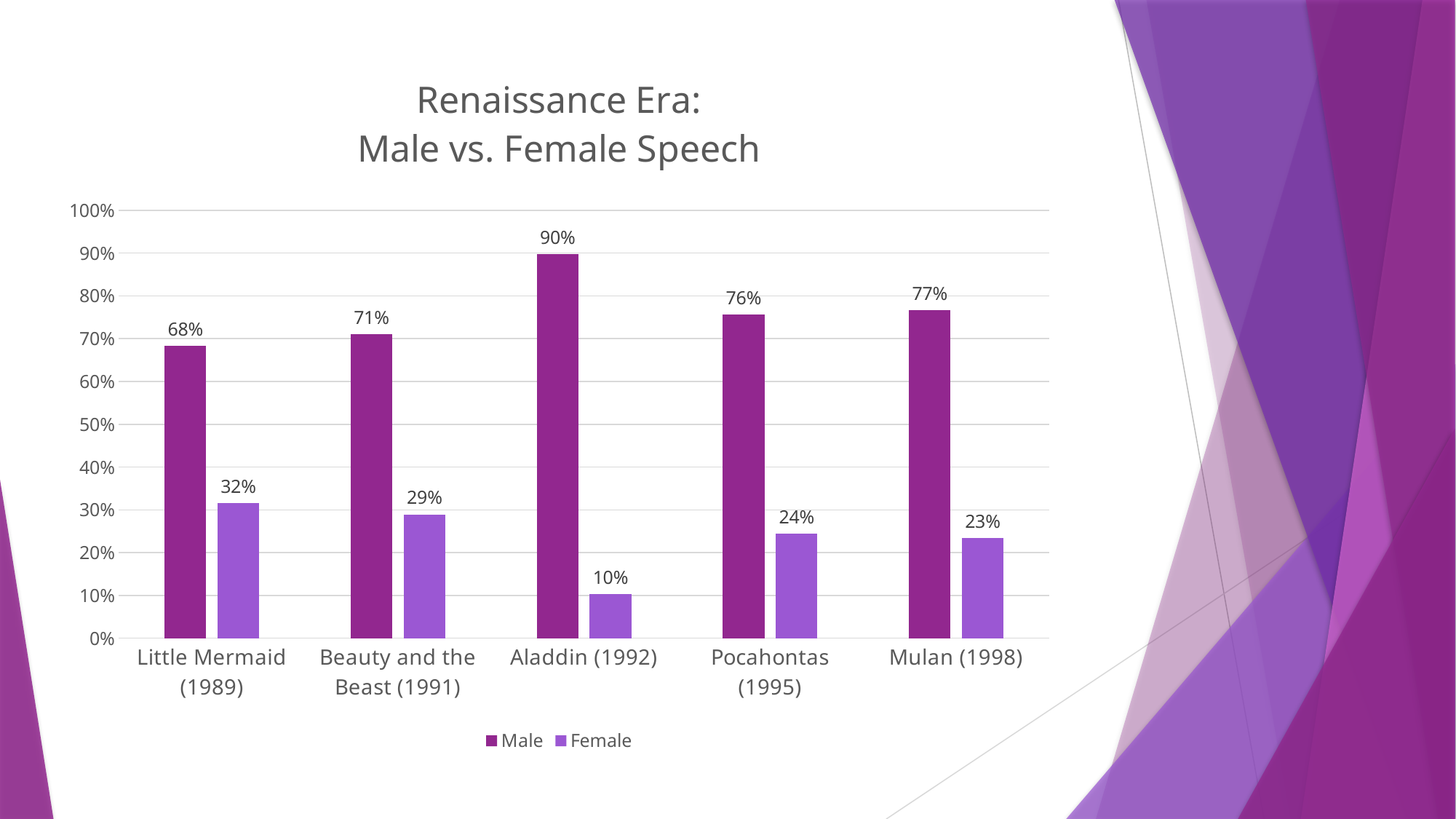
Which film has the highest Male speech percentage? Aladdin (1992) How many films are shown on the x axis? 5 Which film has the lowest Female speech percentage? Aladdin (1992) What kind of chart is shown on the slide? bar chart What is the title of the chart? Renaissance Era: Male vs. Female Speech What is the Male speech percentage for Aladdin (1992)? 90% Is the Male speech percentage for Little Mermaid (1989) greater or less than 60%? greater What is the Female speech percentage for Pocahontas (1995)? 24% How many series does the legend list? 2 What is the difference between the Male and Female speech percentages for Beauty and the Beast (1991)? 42% What is the Female speech percentage for Little Mermaid (1989)? 32% Which is larger, the Female speech percentage for Little Mermaid (1989) or for Mulan (1998)? Little Mermaid (1989)